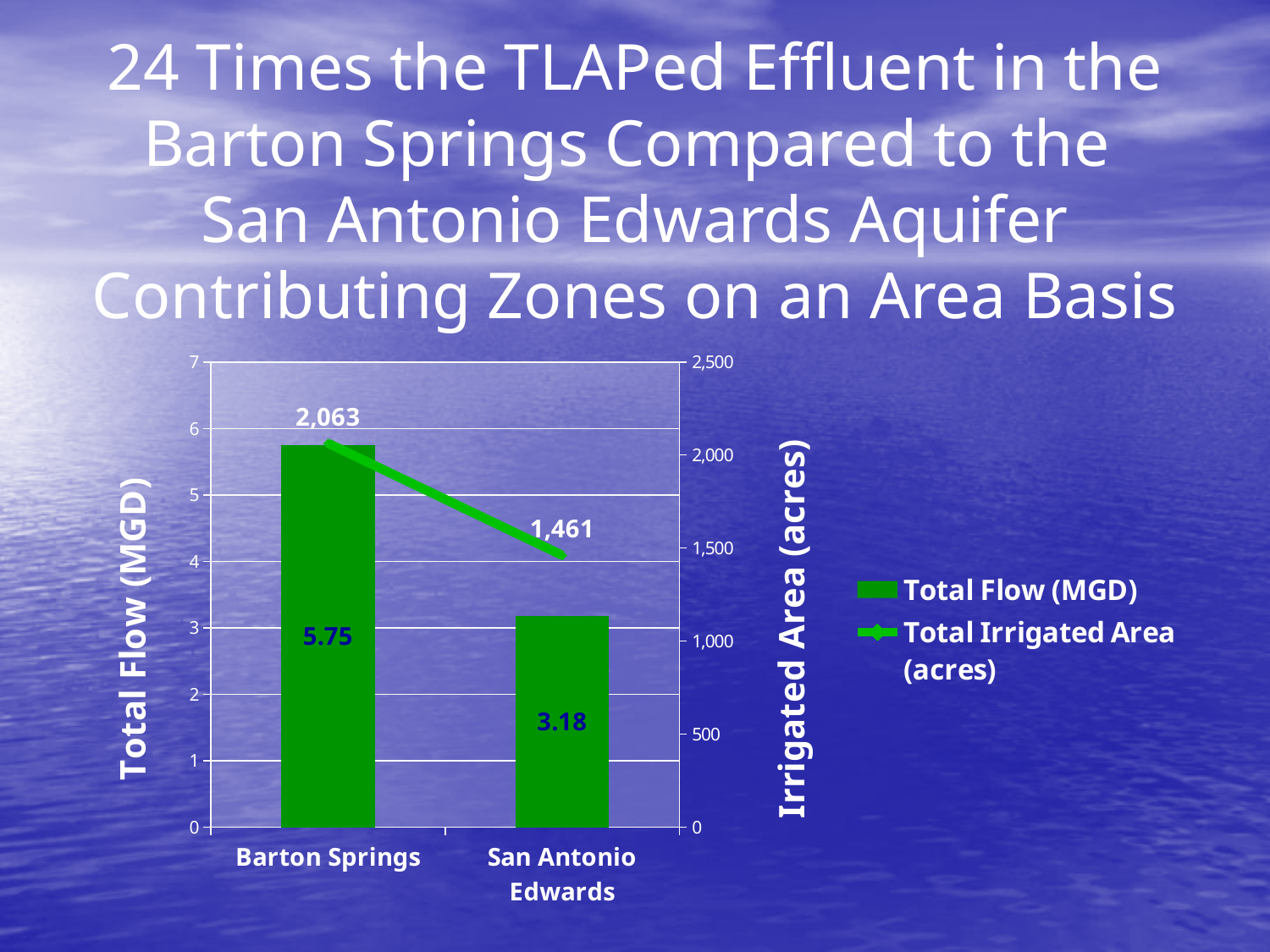
What is the Total Irrigated Area (acres) for Barton Springs? 2,063 What is the Total Irrigated Area (acres) for San Antonio Edwards? 1,461 What is the Total Flow (MGD) for Barton Springs? 5.75 How many series does the legend list? 2 Which has a larger Total Irrigated Area (acres), Barton Springs or San Antonio Edwards? Barton Springs Which category has the lowest Total Irrigated Area (acres)? San Antonio Edwards Which category has the highest Total Flow (MGD)? Barton Springs What is the Total Flow (MGD) for San Antonio Edwards? 3.18 What is the difference in Total Flow (MGD) between Barton Springs and San Antonio Edwards? 2.57 How many categories are shown on the x axis? 2 What is the difference in Total Irrigated Area (acres) between Barton Springs and San Antonio Edwards? 602 What is the label of the left vertical axis? Total Flow (MGD)